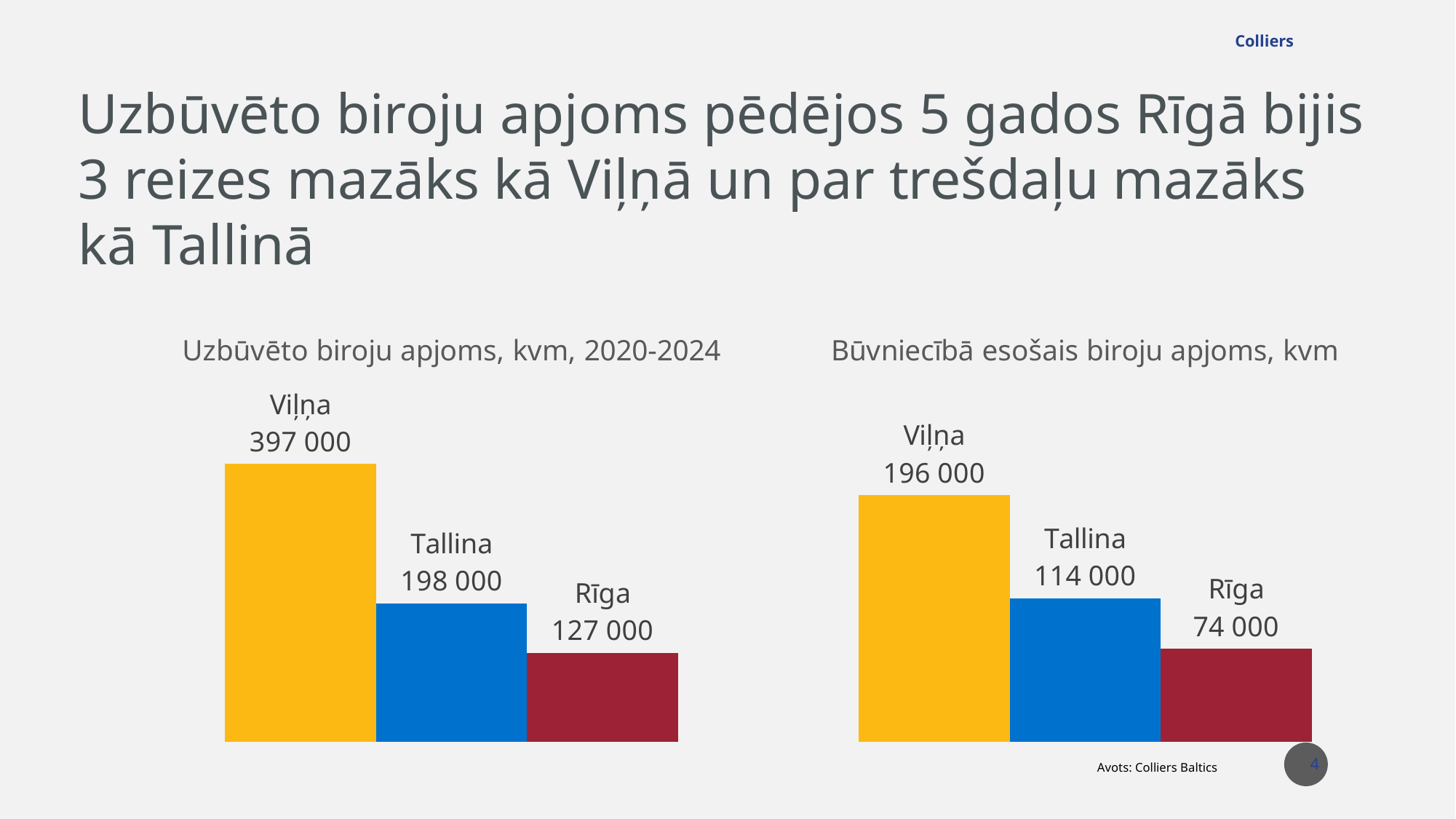
How many cities are shown in the chart 'Uzbūvēto biroju apjoms, kvm, 2020-2024'? 3 In the chart 'Uzbūvēto biroju apjoms, kvm, 2020-2024', what colour is the bar for Tallina? Blue In the chart 'Uzbūvēto biroju apjoms, kvm, 2020-2024', what is the value for Viļņa? 397 000 In the chart 'Būvniecībā esošais biroju apjoms, kvm', what is the value for Tallina? 114 000 In the chart 'Būvniecībā esošais biroju apjoms, kvm', what is the difference between the values for Tallina and Rīga? 40 000 In the chart 'Būvniecībā esošais biroju apjoms, kvm', which is larger, the value for Viļņa or the value for Tallina? Viļņa In the chart 'Uzbūvēto biroju apjoms, kvm, 2020-2024', what is the difference between the values for Viļņa and Tallina? 199 000 In the chart 'Būvniecībā esošais biroju apjoms, kvm', which city has the lowest value? Rīga In the chart 'Uzbūvēto biroju apjoms, kvm, 2020-2024', which city has the highest value? Viļņa In the chart 'Uzbūvēto biroju apjoms, kvm, 2020-2024', what is the value for Rīga? 127 000 What kind of chart is 'Būvniecībā esošais biroju apjoms, kvm'? Bar chart In the chart 'Būvniecībā esošais biroju apjoms, kvm', what is the value for Rīga? 74 000